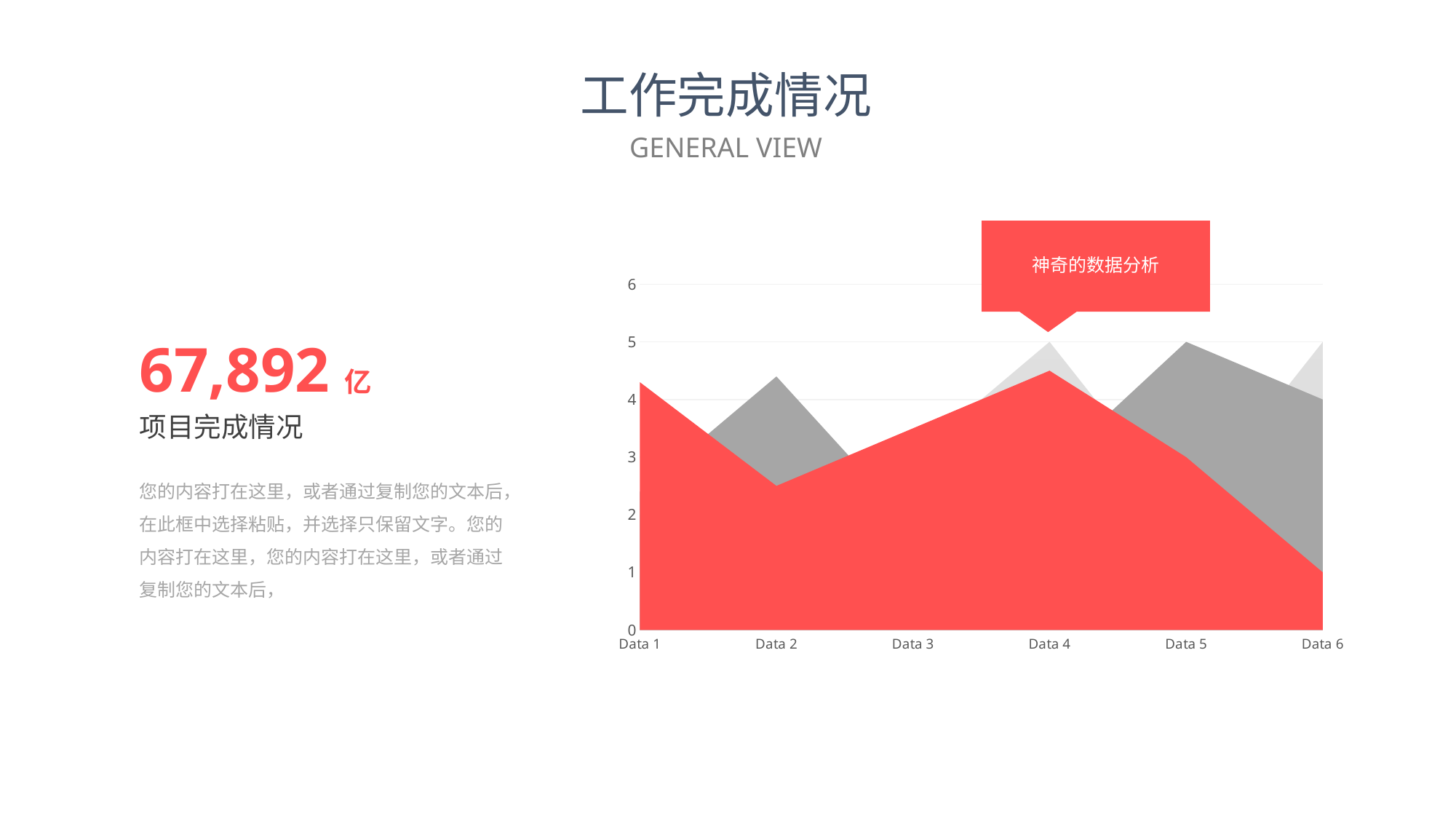
What is the value of the dark gray series at Data 5? 5 Is the value of the dark gray series at Data 2 greater or less than 4? greater What kind of chart is shown on the slide? area chart Is the value of the red series at Data 2 greater or less than 3? less Does the red series rise or fall from Data 4 to Data 6? fall How many categories are shown on the x axis of the chart? 6 Is the value of the red series at Data 1 greater or less than 4? greater What text is shown in the red callout box above the chart? 神奇的数据分析 Which category has the lowest value for the red series? Data 6 For the red series, which is larger: the value at Data 1 or the value at Data 2? Data 1 Which category has the highest value for the dark gray series? Data 5